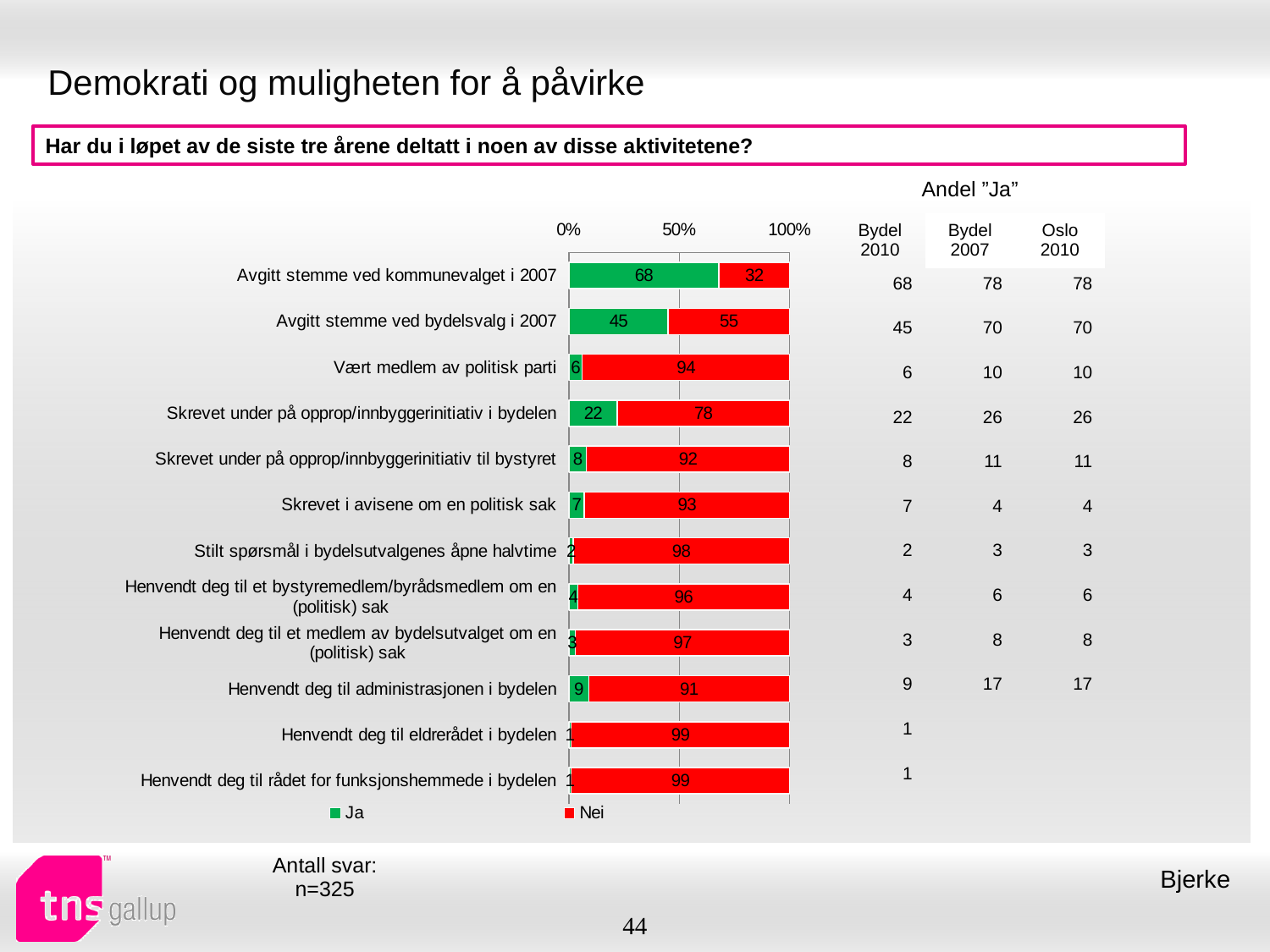
What is the "Nei" value for "Avgitt stemme ved bydelsvalg i 2007"? 55 Which category has the lowest "Nei" value? Avgitt stemme ved kommunevalget i 2007 Which category has the highest "Ja" value? Avgitt stemme ved kommunevalget i 2007 What is the difference between the "Ja" values for "Avgitt stemme ved kommunevalget i 2007" and "Avgitt stemme ved bydelsvalg i 2007"? 23 What is the "Ja" value for "Avgitt stemme ved kommunevalget i 2007"? 68 What is the "Ja" value for "Skrevet under på opprop/innbyggerinitiativ i bydelen"? 22 What is the total of the stacked bar for "Skrevet i avisene om en politisk sak"? 100 How many series does the legend list? 2 What is the "Nei" value for "Henvendt deg til administrasjonen i bydelen"? 91 Which has a larger "Ja" value: "Vært medlem av politisk parti" or "Skrevet under på opprop/innbyggerinitiativ i bydelen"? Skrevet under på opprop/innbyggerinitiativ i bydelen What kind of chart is shown on the slide? Stacked bar chart How many categories are shown in the chart? 12